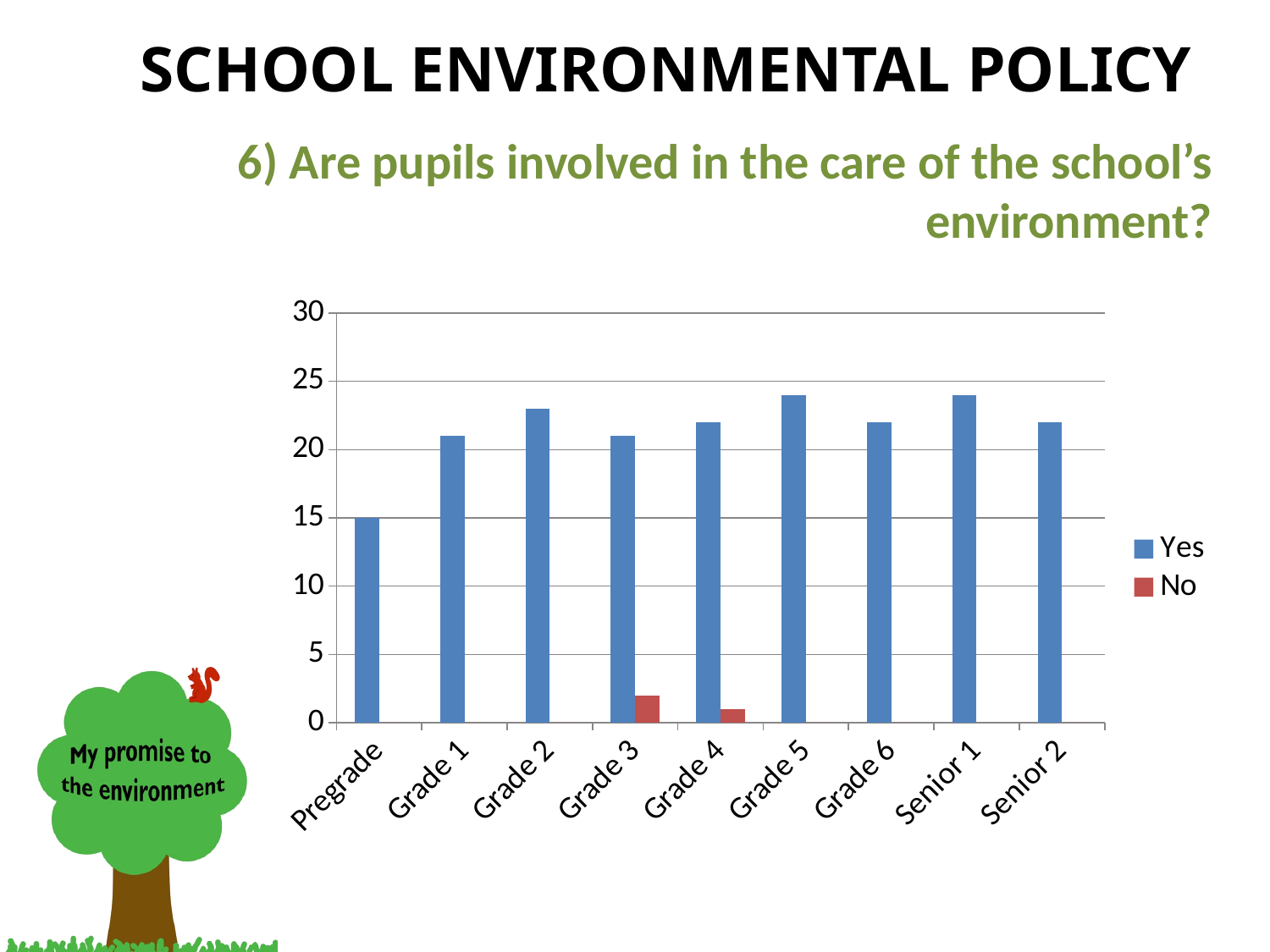
What kind of chart is shown on the slide? bar chart Is the Yes value for Pregrade greater or less than 20? less Is the No value for Grade 3 greater or less than 5? less How many series does the legend list? 2 What are the two entries in the chart legend? Yes and No Which category has the lowest Yes value? Pregrade Is the Yes value for Grade 2 greater or less than 20? greater Which is larger, the No value for Grade 3 or the No value for Grade 4? Grade 3 Which is larger, the Yes value for Pregrade or the Yes value for Grade 1? Grade 1 How many categories are shown on the x axis? 9 What is the Yes value for Pregrade? 15